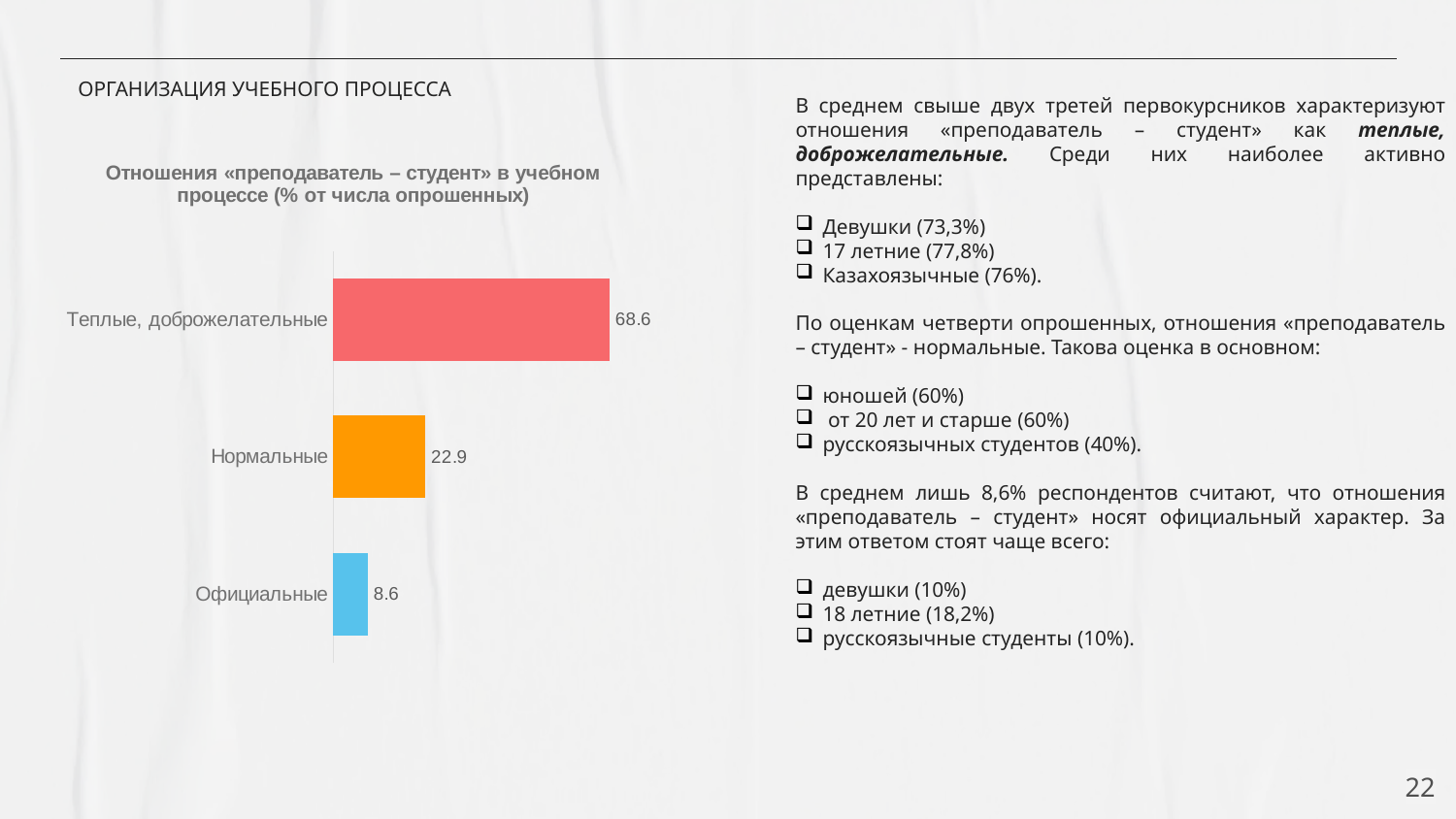
What is the total of the three values shown in the chart? 100.1 What value is shown for «Официальные»? 8.6 What is the title of the chart? Отношения «преподаватель – студент» в учебном процессе (% от числа опрошенных) What is the difference between the values for «Теплые, доброжелательные» and «Нормальные»? 45.7 How many categories are shown in the chart? 3 Which category has the lowest value? Официальные What is the difference between the values for «Нормальные» and «Официальные»? 14.3 What value is shown for «Нормальные»? 22.9 Which is larger: the value for «Нормальные» or for «Официальные»? Нормальные What value is shown for «Теплые, доброжелательные»? 68.6 What kind of chart is this? Bar chart Which category has the highest value? Теплые, доброжелательные